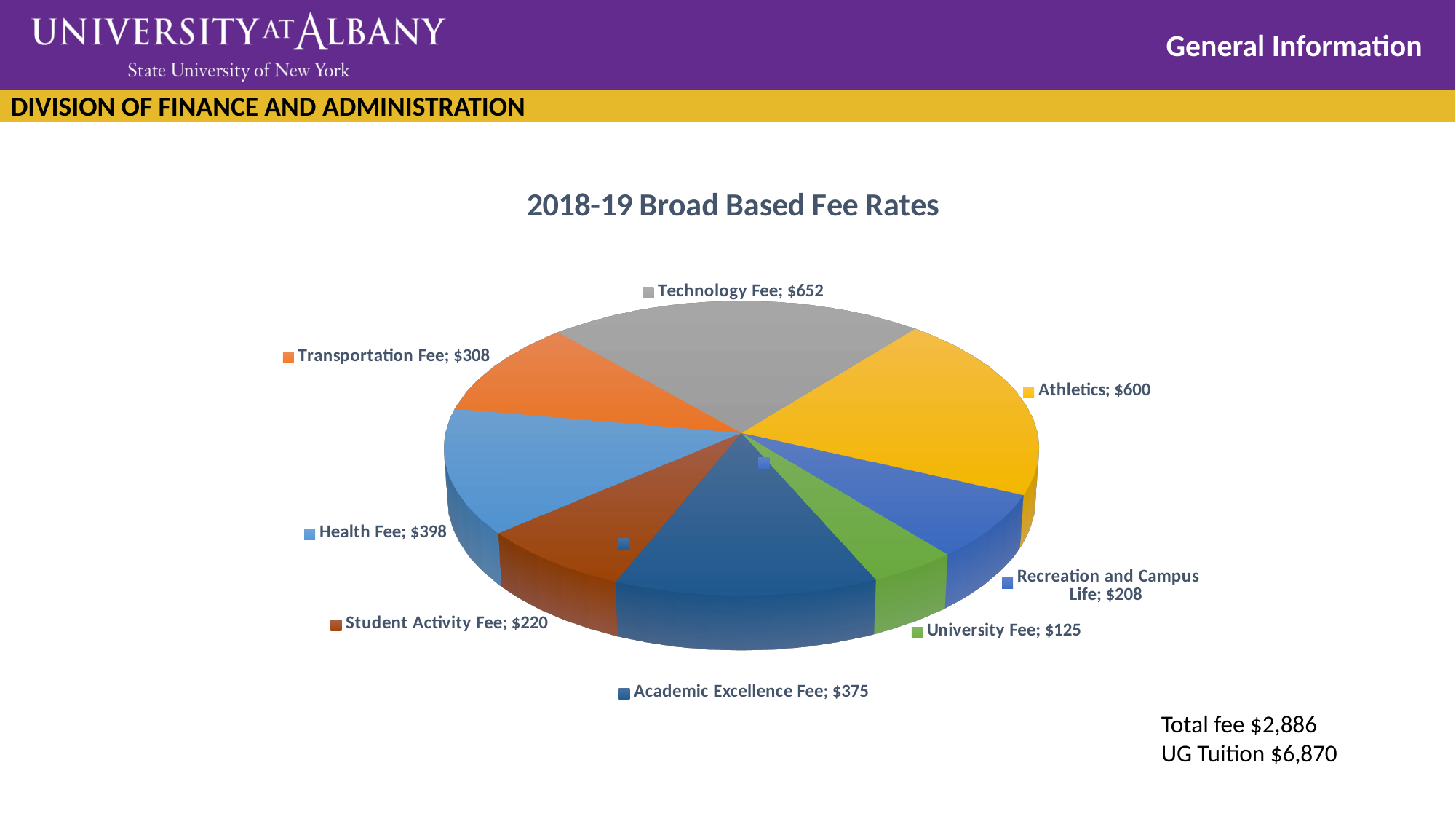
What is the total of all the fees shown in the pie chart? $2,886 Which fee has the highest value? Technology Fee What is the value for Academic Excellence Fee? $375 Which fee has the lowest value? University Fee What is the value for Recreation and Campus Life? $208 What kind of chart is shown on the slide? Pie chart What is the difference between the Technology Fee and the Athletics fee? $52 How many fee categories are shown in the pie chart? 8 Which is larger, the Transportation Fee or the Student Activity Fee? Transportation Fee What is the value for Health Fee? $398 What is the title of the chart? 2018-19 Broad Based Fee Rates What is the value for Technology Fee? $652